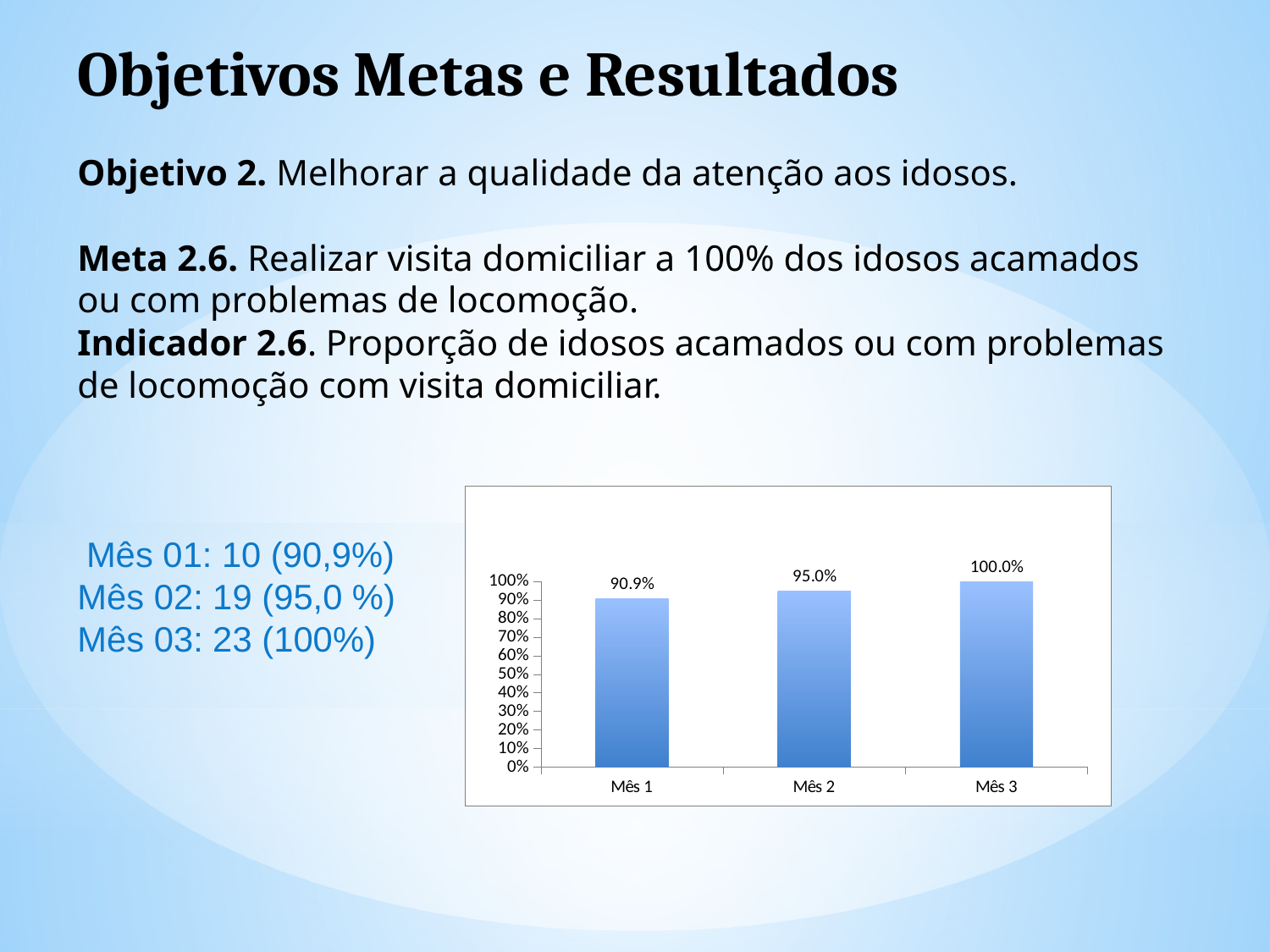
Is the value for Mês 1 greater or less than 80%? greater Do the values rise or fall from Mês 1 to Mês 3? rise What is the difference between the values for Mês 2 and Mês 1? 4.1% What is the difference between the values for Mês 3 and Mês 1? 9.1% What is the value for Mês 3? 100.0% Which category has the highest value? Mês 3 Which category has the lowest value? Mês 1 What is the value for Mês 1? 90.9% What is the value for Mês 2? 95.0% How many categories are shown on the x axis? 3 Which is larger, the value for Mês 2 or the value for Mês 1? Mês 2 What kind of chart is shown on the slide? bar chart